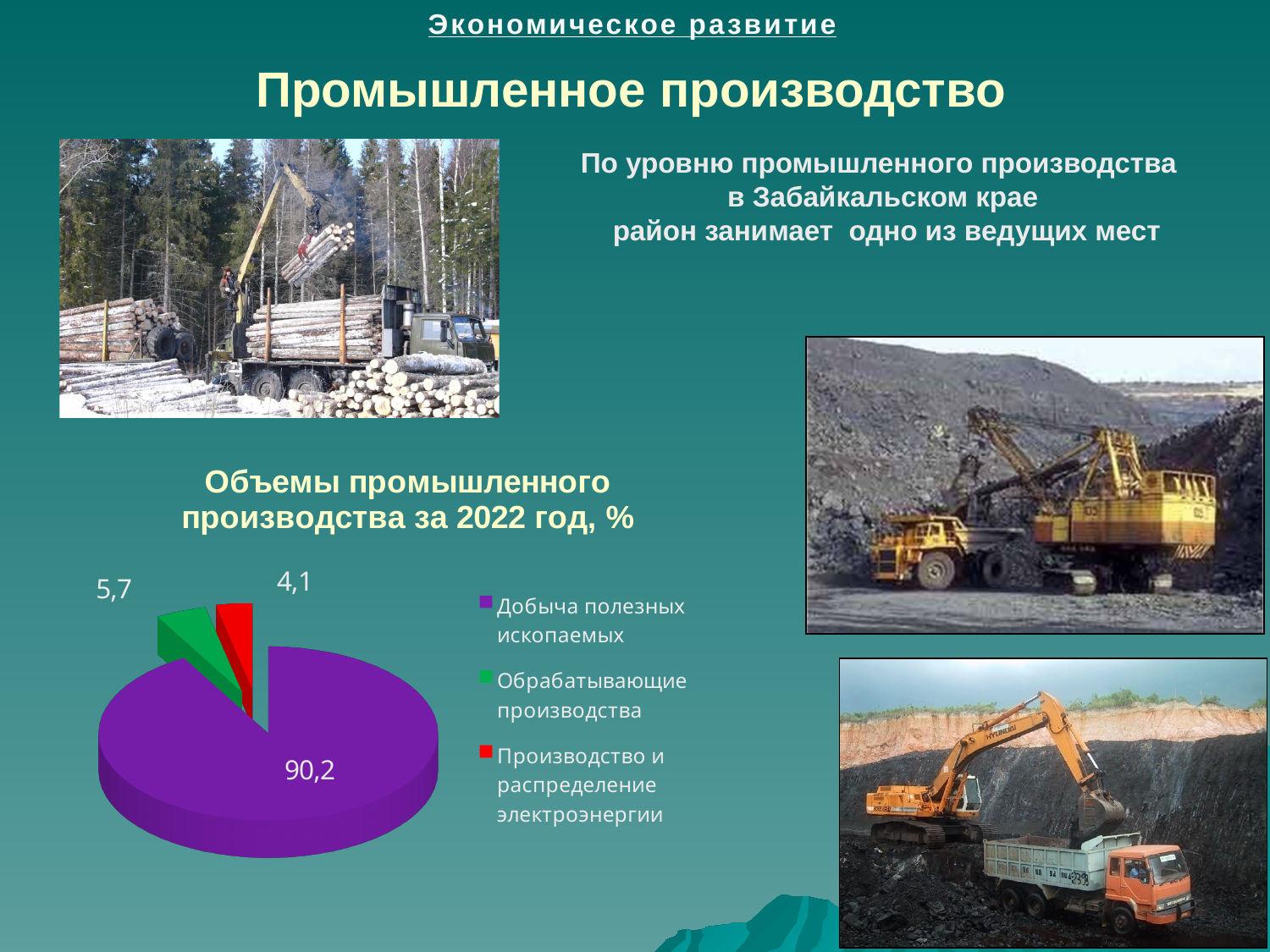
What is the difference between the values for Обрабатывающие производства and Производство и распределение электроэнергии? 1,6 Which category has the smallest slice of the pie chart? Производство и распределение электроэнергии What is the value for Обрабатывающие производства in the pie chart? 5,7 Which category has the largest slice of the pie chart? Добыча полезных ископаемых What colour is the slice for Обрабатывающие производства in the pie chart? Green What kind of chart is shown on the slide? Pie chart What is the difference between the values for Добыча полезных ископаемых and Обрабатывающие производства? 84,5 What is the title of the pie chart? Объемы промышленного производства за 2022 год, % How many categories does the pie chart show? 3 What is the value for Производство и распределение электроэнергии in the pie chart? 4,1 Which is larger: the value for Обрабатывающие производства or the value for Производство и распределение электроэнергии? Обрабатывающие производства What is the value for Добыча полезных ископаемых in the pie chart? 90,2